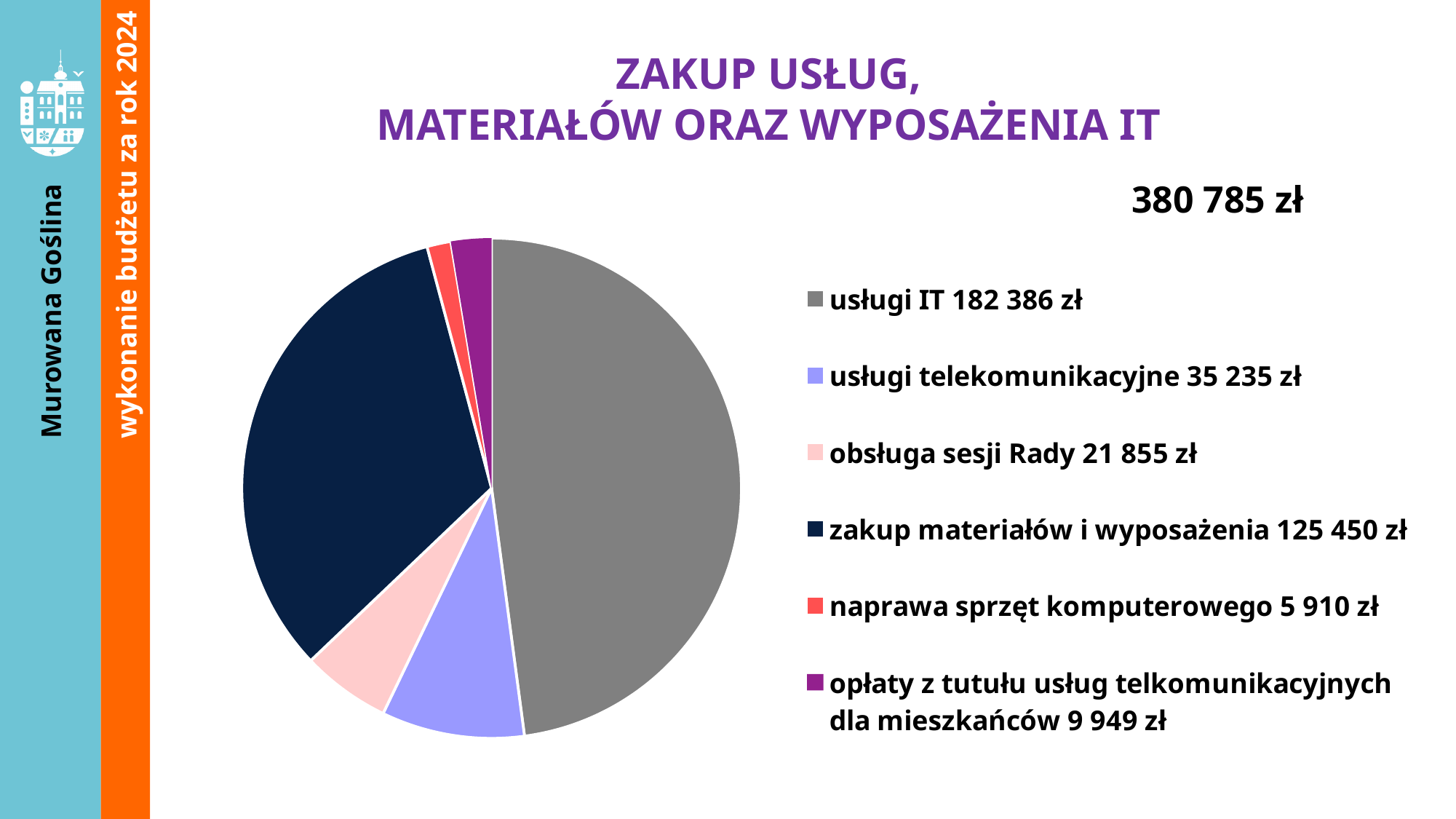
What is the value for naprawa sprzęt komputerowego? 5 910 zł What kind of chart is shown on the slide? pie chart What is the value for usługi IT? 182 386 zł What is the value for obsługa sesji Rady? 21 855 zł What is the difference between usługi IT and zakup materiałów i wyposażenia? 56 936 zł What total amount is shown above the legend on the slide? 380 785 zł Which category has the largest slice of the pie? usługi IT Which category has the smallest slice of the pie? naprawa sprzęt komputerowego What is the value for zakup materiałów i wyposażenia? 125 450 zł How many categories does the pie chart show? 6 Which is larger: usługi telekomunikacyjne or opłaty z tutułu usług telkomunikacyjnych dla mieszkańców? usługi telekomunikacyjne What is the difference between usługi telekomunikacyjne and obsługa sesji Rady? 13 380 zł